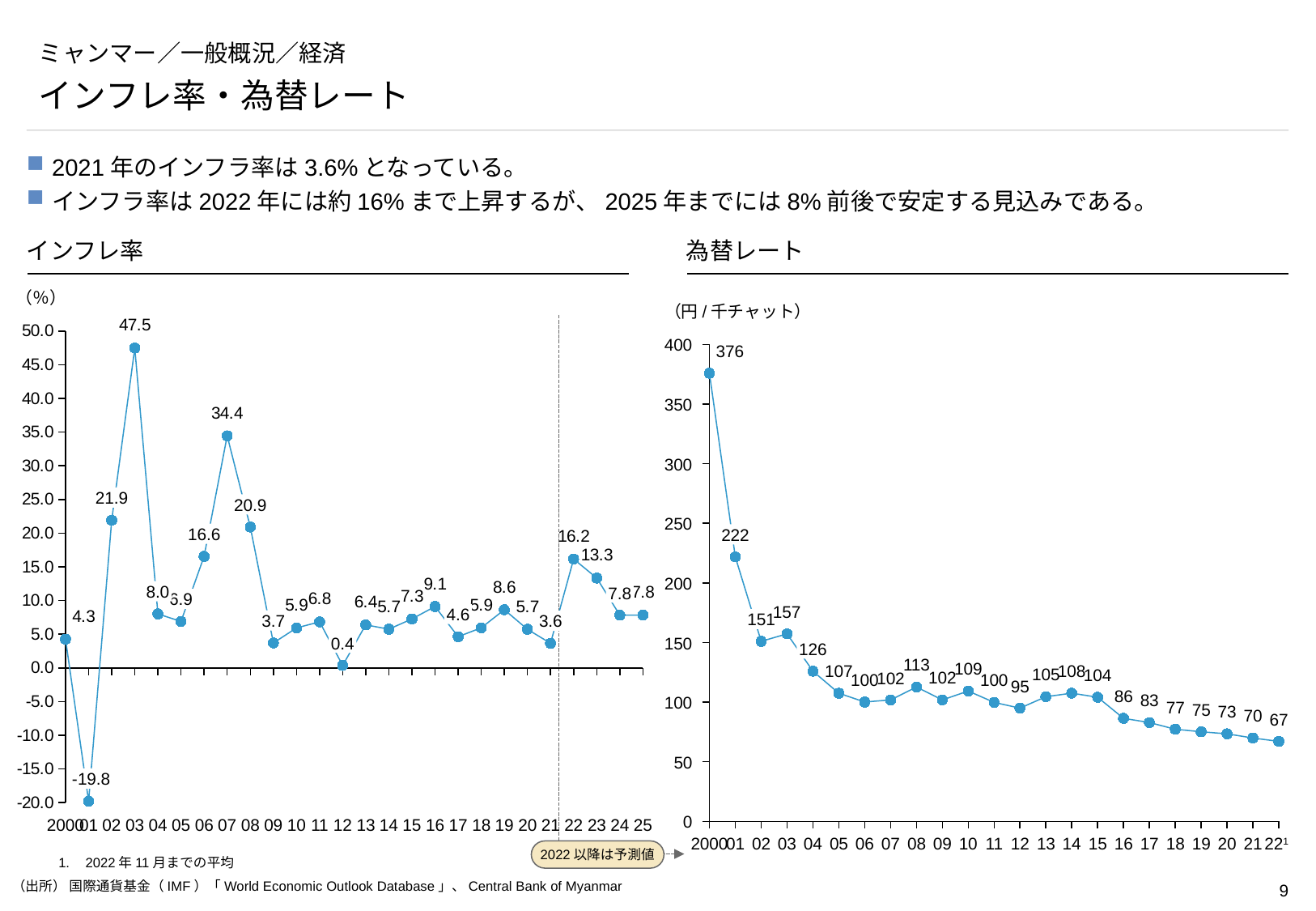
On the インフレ率 chart, what is the value for 2021? 3.6 On the 為替レート chart, what is the value for 2022? 67 On the インフレ率 chart, which year has the highest value? 2003 On the 為替レート chart, what is the value for 2000? 376 On the インフレ率 chart, which is larger, the value for 2007 or the value for 2008? 2007 On the 為替レート chart, how many data points are plotted? 23 On the インフレ率 chart, what is the difference between the 2022 value and the 2021 value? 12.6 On the インフレ率 chart, what is the inflation rate for 2003? 47.5 On the 為替レート chart, what is the difference between the 2000 value and the 2001 value? 154 On the インフレ率 chart, which year has the lowest value? 2001 On the 為替レート chart, do the values generally rise or fall from 2000 to 2022? fall What type of chart is the インフレ率 chart? line chart